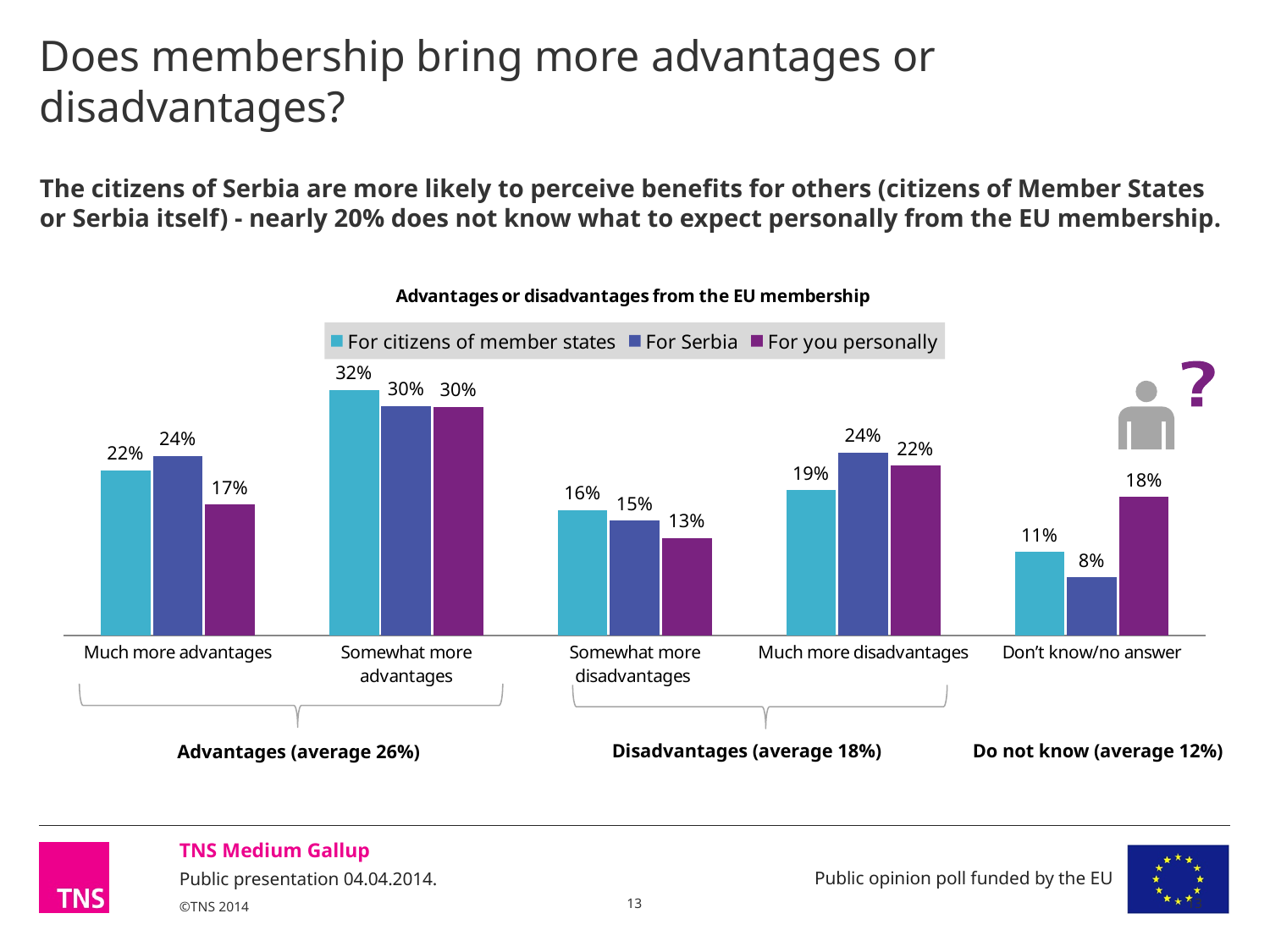
What is the value for 'For citizens of member states' in the 'Much more disadvantages' category? 19% Which category has the lowest value for 'For Serbia'? Don't know/no answer What is the value for 'For you personally' in the 'Somewhat more disadvantages' category? 13% How many series does the legend list? 3 How many categories are shown on the x axis? 5 What is the title of the chart? Advantages or disadvantages from the EU membership What is the difference between 'For citizens of member states' and 'For you personally' in the 'Much more advantages' category? 5% What kind of chart is shown on the slide? Bar chart In the 'Somewhat more disadvantages' category, which is larger: 'For citizens of member states' or 'For you personally'? For citizens of member states What is the value for 'For Serbia' in the 'Somewhat more advantages' category? 30% Which category has the highest value for 'For citizens of member states'? Somewhat more advantages What is the value for 'For you personally' in the 'Don't know/no answer' category? 18%